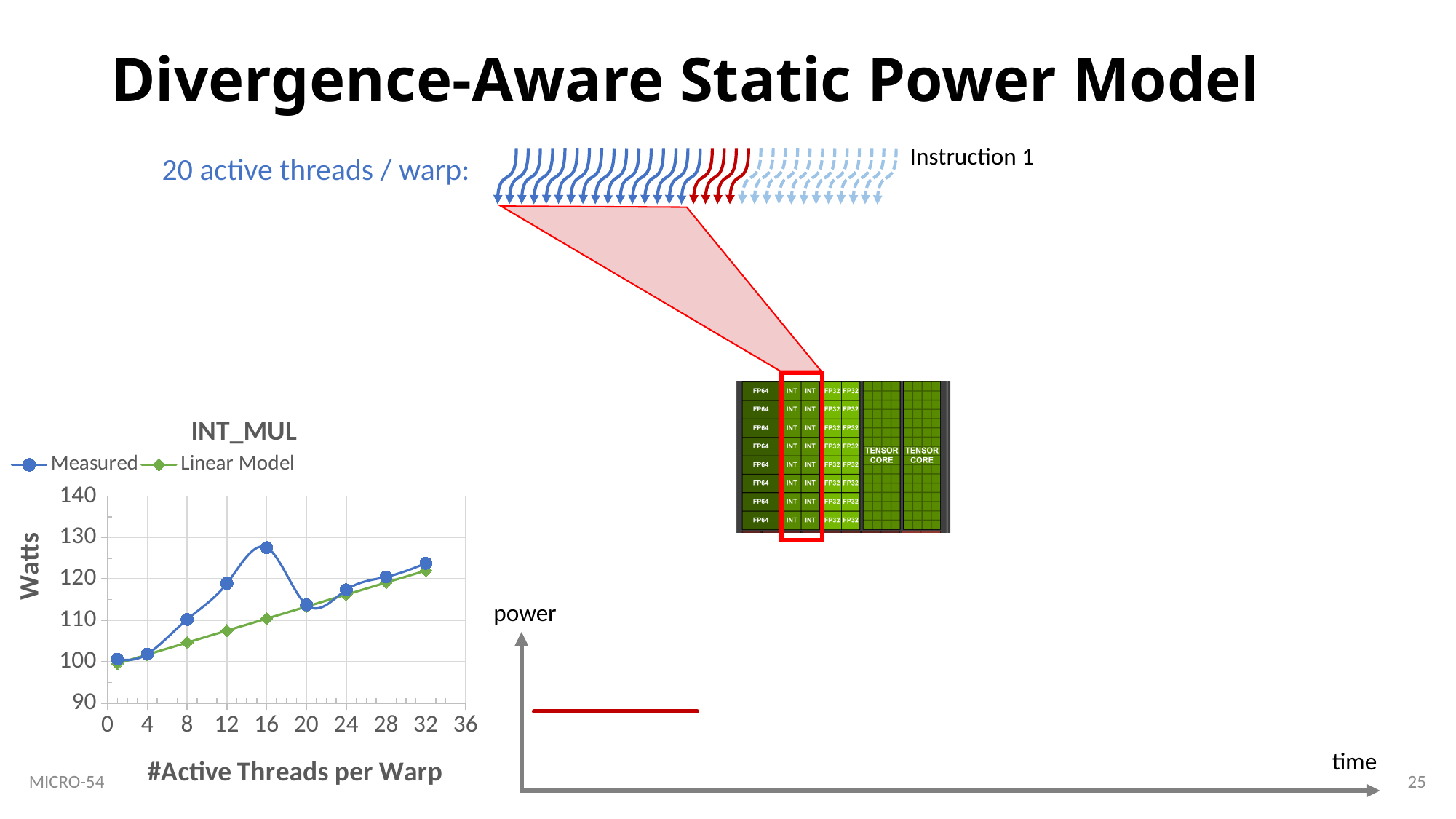
In the INT_MUL chart, is the Measured value at 8 active threads per warp greater or less than 120? less In the INT_MUL chart, at which number of active threads per warp is the Linear Model series highest? 32 In the INT_MUL chart, does the Linear Model series rise or fall as the number of active threads per warp increases? rise How many data points does the Measured series have in the INT_MUL chart? 9 In the INT_MUL chart, is the Measured value at 16 active threads per warp greater or less than 120? greater In the INT_MUL chart, at 16 active threads per warp, which series has the larger value, Measured or Linear Model? Measured In the INT_MUL chart, at which number of active threads per warp does the Measured series reach its highest value? 16 How many series does the legend of the INT_MUL chart list? 2 What is the y-axis label of the INT_MUL chart? Watts In the INT_MUL chart, is the Linear Model value at 16 active threads per warp greater or less than 120? less What are the two series named in the legend of the INT_MUL chart? Measured and Linear Model What kind of chart is the INT_MUL chart? line chart